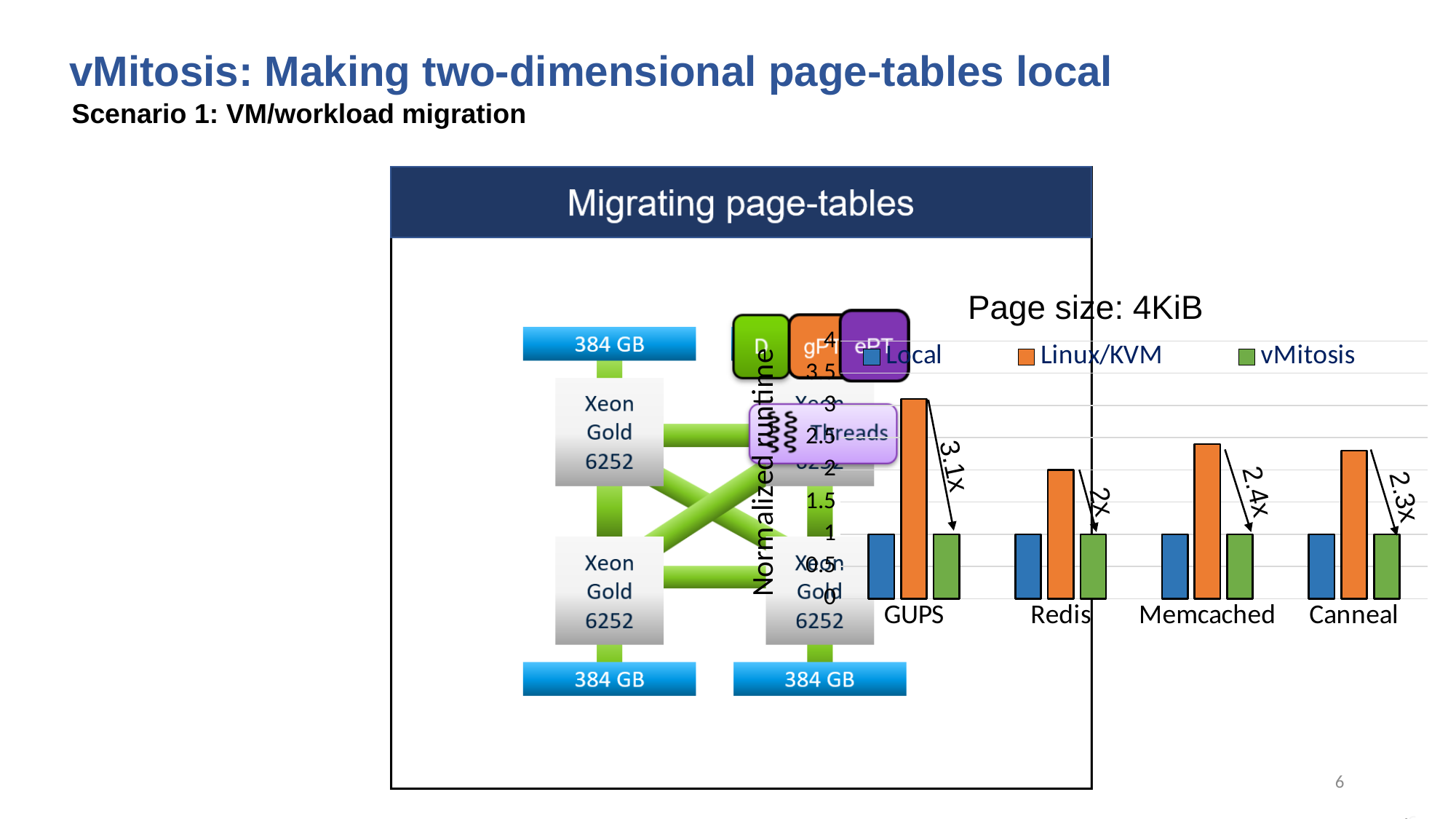
Is the Linux/KVM value for GUPS greater or less than 3? greater What kind of chart is shown on the slide? bar chart How many series does the chart legend list? 3 What page size is stated above the chart? 4KiB Which workload has the lowest Linux/KVM normalized runtime? Redis Is the Linux/KVM value for Canneal greater or less than 3? less What speedup factor is annotated between Linux/KVM and vMitosis for GUPS? 3.1x Which workload has the highest Linux/KVM normalized runtime? GUPS Is the Linux/KVM value for Memcached greater or less than 2? greater How many workload categories are shown on the x axis of the chart? 4 What speedup factor is annotated between Linux/KVM and vMitosis for Memcached? 2.4x What is the label of the y axis of the chart? Normalized runtime